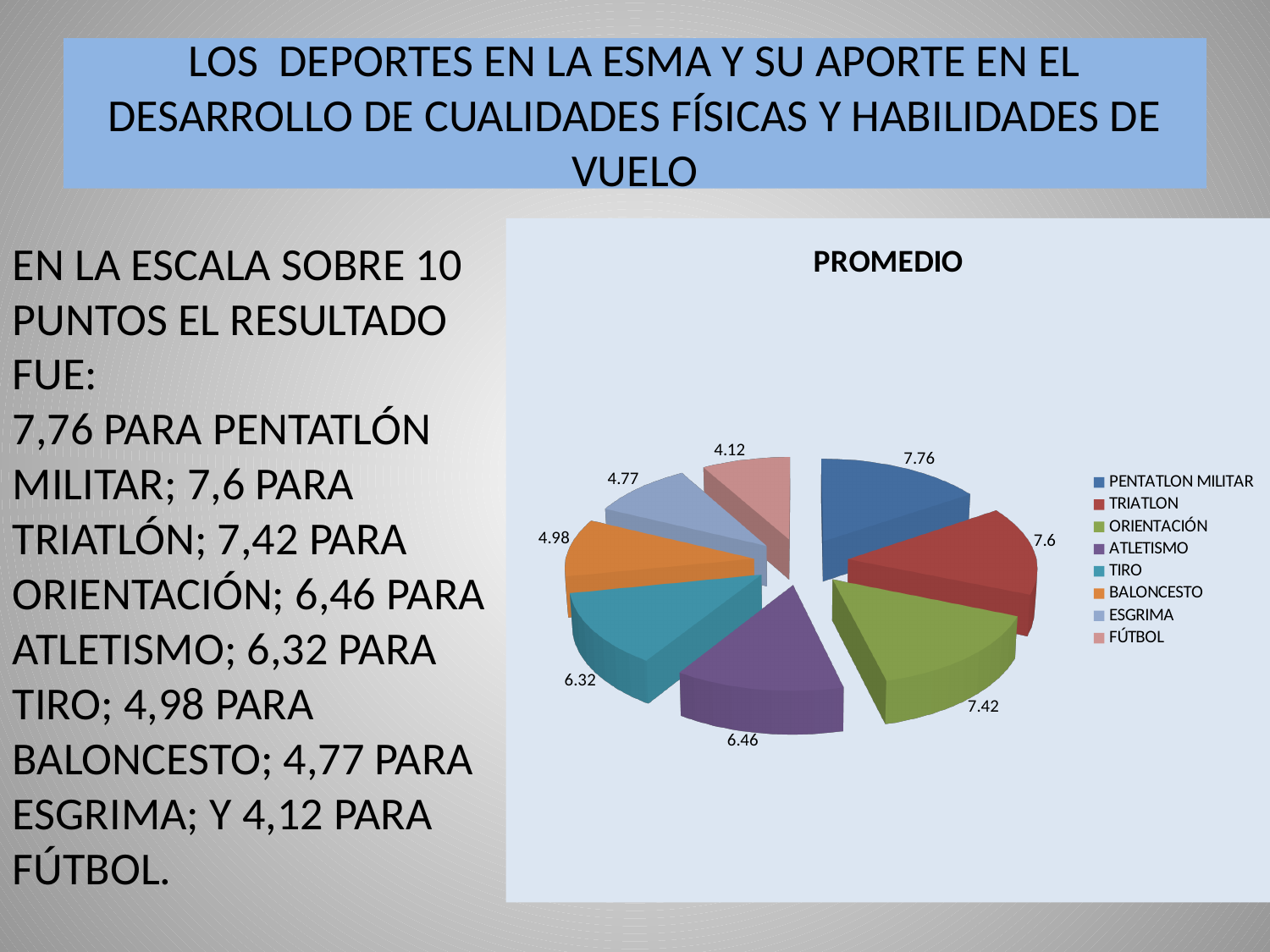
Which category has the highest value in the pie chart? PENTATLON MILITAR What is the value for PENTATLON MILITAR in the pie chart? 7.76 Which has a larger value, ATLETISMO or BALONCESTO? ATLETISMO What kind of chart is shown on the slide? Pie chart What is the value for TIRO in the pie chart? 6.32 What is the value for ESGRIMA in the pie chart? 4.77 What is the title of the chart? PROMEDIO Which category has the lowest value in the pie chart? FÚTBOL What is the value for BALONCESTO in the pie chart? 4.98 How many categories does the legend of the pie chart list? 8 What is the difference between the values for TRIATLON and ORIENTACIÓN? 0.18 What is the difference between the values for PENTATLON MILITAR and FÚTBOL? 3.64